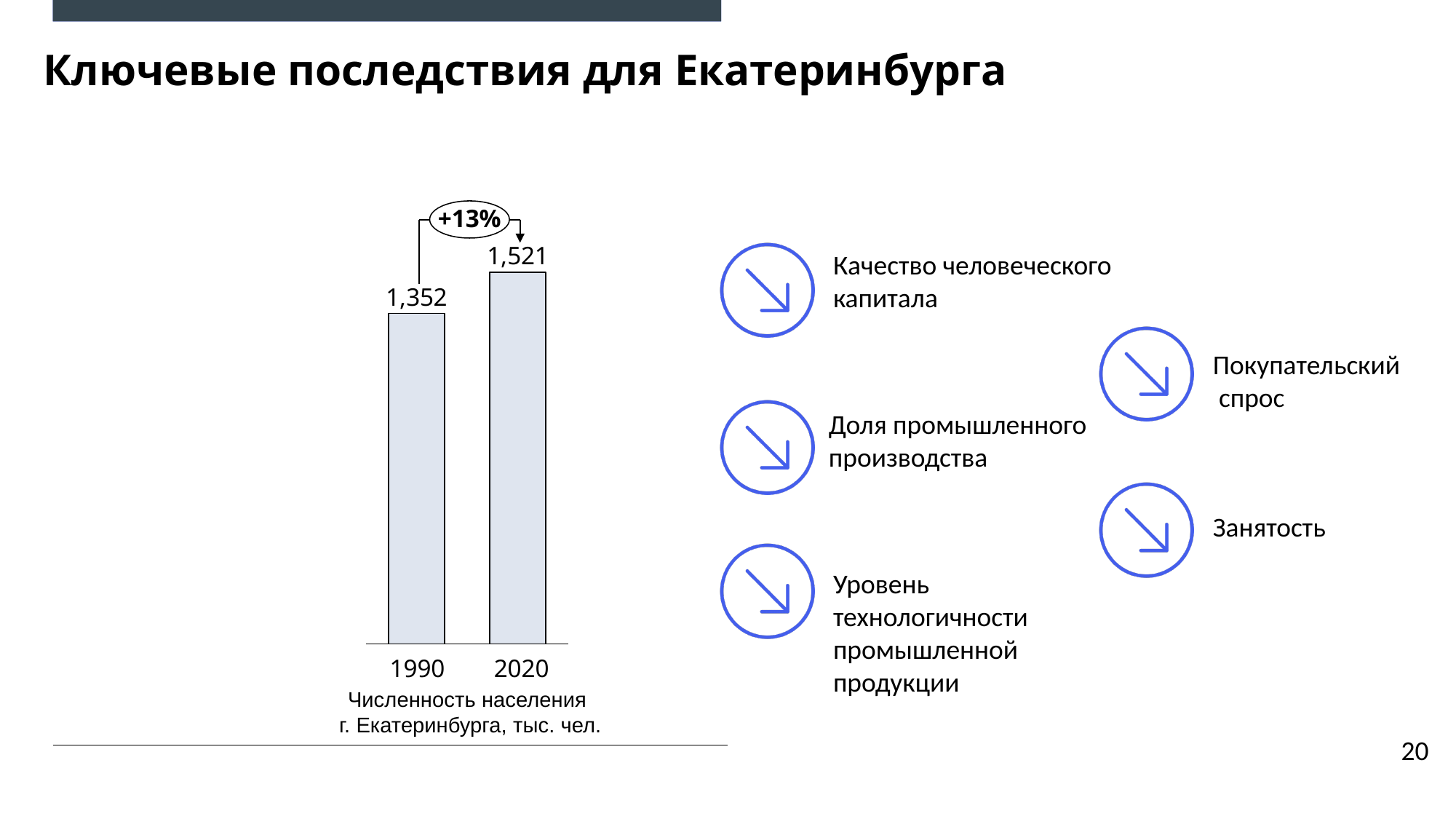
What kind of chart is shown on the slide? Bar chart Is the value for 2020 larger than the value for 1990? Yes What is the caption under the chart? Численность населения г. Екатеринбурга, тыс. чел. How many years (categories) are shown on the chart? 2 What is the population value shown for 1990? 1,352 Which year has the higher population value? 2020 What percentage change is annotated between the 1990 and 2020 bars? +13% What is the difference between the 2020 and 1990 population values? 169 What is the population value shown for 2020? 1,521 Does the population value rise or fall from 1990 to 2020? Rise Which year has the lower population value? 1990